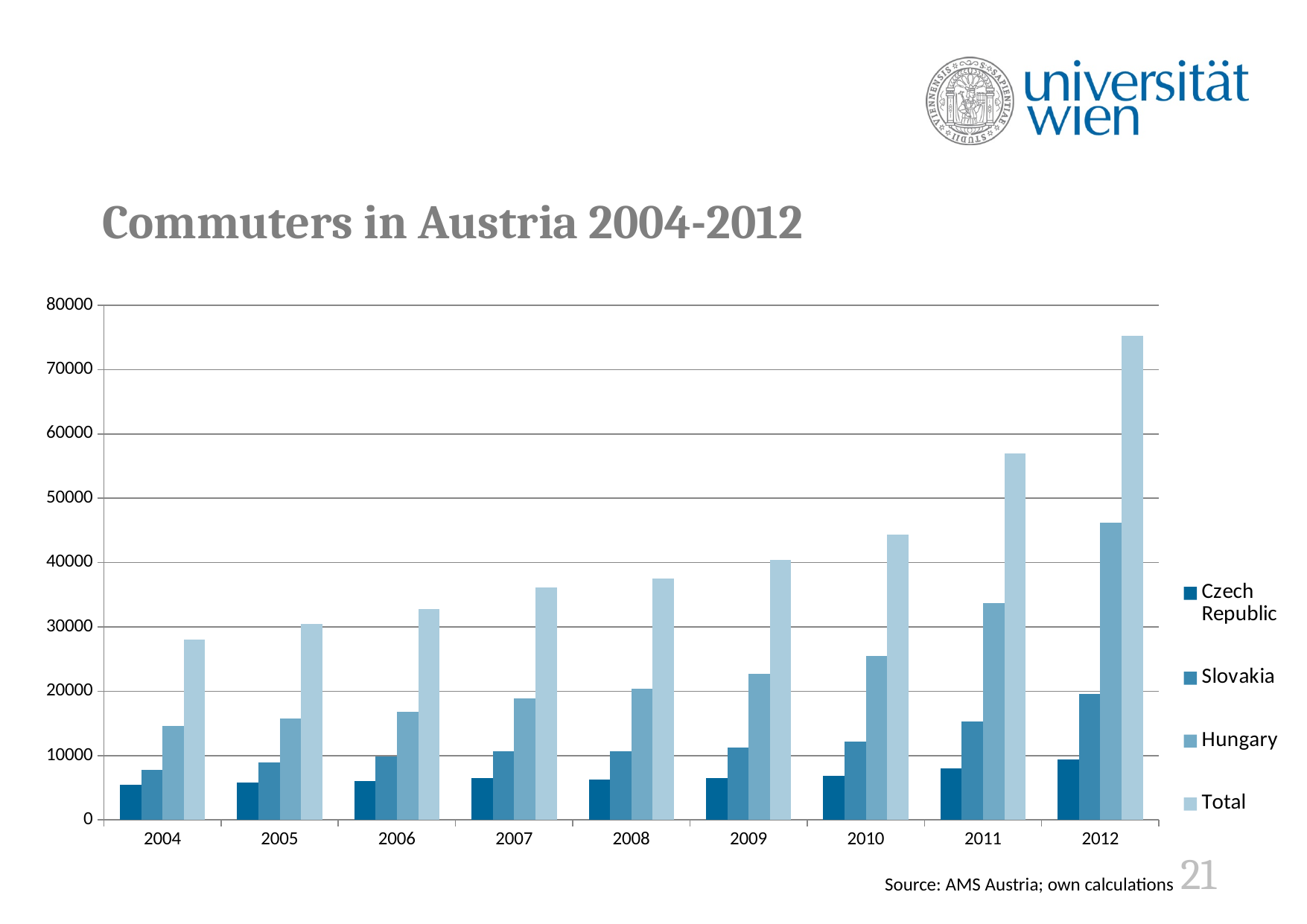
What kind of chart is shown on the slide? bar chart Is the Total value for 2012 greater or less than 70000? greater In 2012, which is larger: the value for Hungary or the value for Slovakia? Hungary In which year is the Total value highest? 2012 What is the title of the chart? Commuters in Austria 2004-2012 In which year is the Total value lowest? 2004 Is the value for Hungary in 2012 greater or less than 50000? less Does the Total value rise or fall from 2004 to 2012? rise How many series does the legend list? 4 How many years are shown on the x axis? 9 Is the value for Slovakia in 2004 greater or less than 10000? less